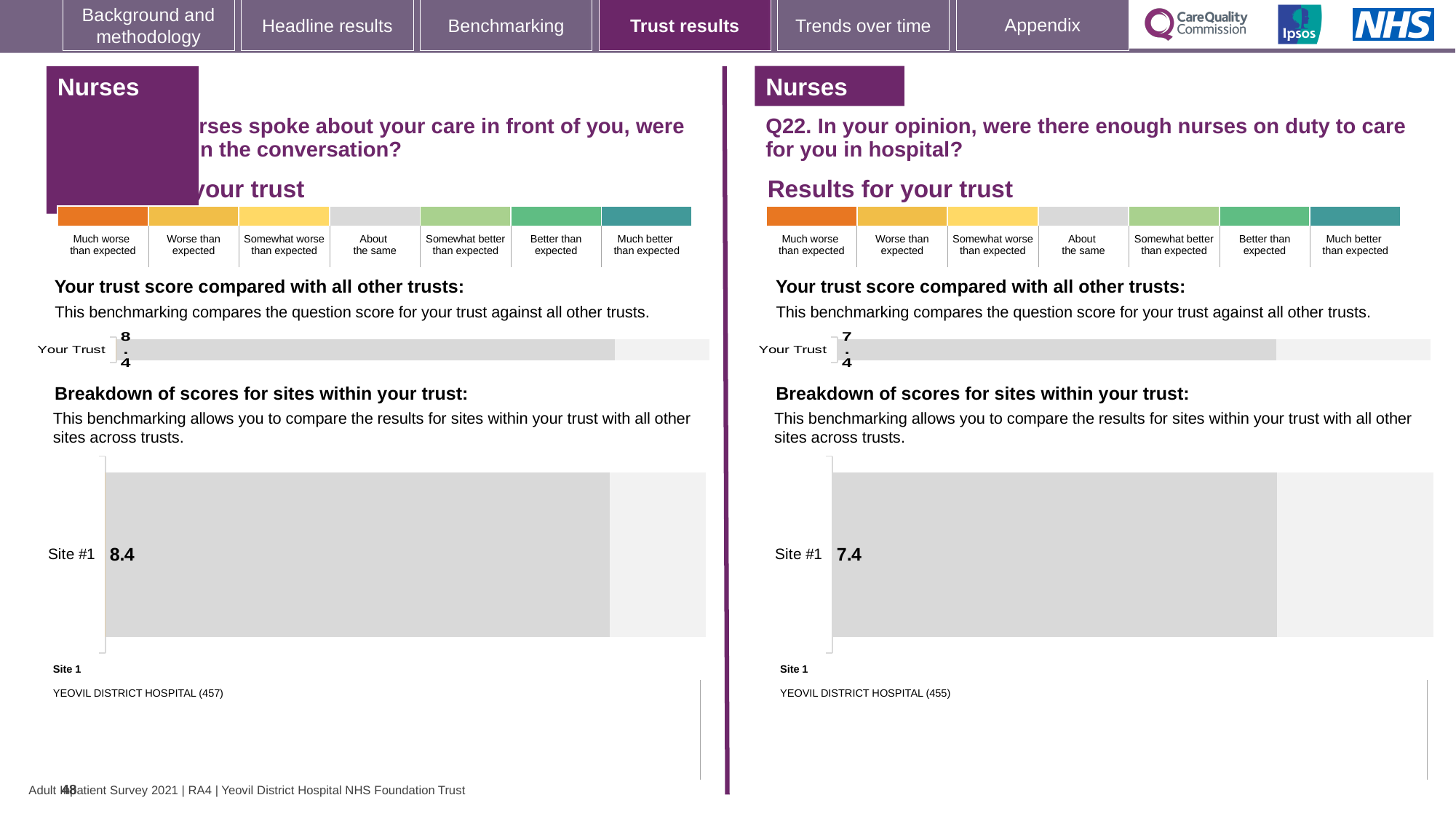
How many benchmark categories are shown in the colour scale above the 'Your trust score' chart for Q22 on the right half of the slide? 7 On the right half of the slide (Q22), what is the score shown for Your Trust in the 'Your trust score compared with all other trusts' chart? 7.4 What is the difference between the Site #1 score on the left half of the slide and the Site #1 score for Q22 on the right half? 1.0 Which is larger: the Your Trust score on the left half of the slide or the Your Trust score for Q22 on the right half? The left half (8.4) How many sites are shown in the 'Breakdown of scores for sites within your trust' chart for Q22 on the right half of the slide? 1 In the 'Breakdown of scores for sites within your trust' chart on the left half of the slide, what is the score for Site #1? 8.4 What type of chart is used to show the Your Trust score on the left half of the slide? Bar chart How many sites are shown in the 'Breakdown of scores for sites within your trust' chart on the left half of the slide? 1 On the left half of the slide, what is the score shown for Your Trust in the 'Your trust score compared with all other trusts' chart? 8.4 Which hospital is listed as Site 1 beneath the site breakdown chart for Q22 on the right half of the slide? YEOVIL DISTRICT HOSPITAL (455) In the 'Breakdown of scores for sites within your trust' chart for Q22 on the right half of the slide, what is the score for Site #1? 7.4 What type of chart is used to show the Site #1 score for Q22 on the right half of the slide? Bar chart